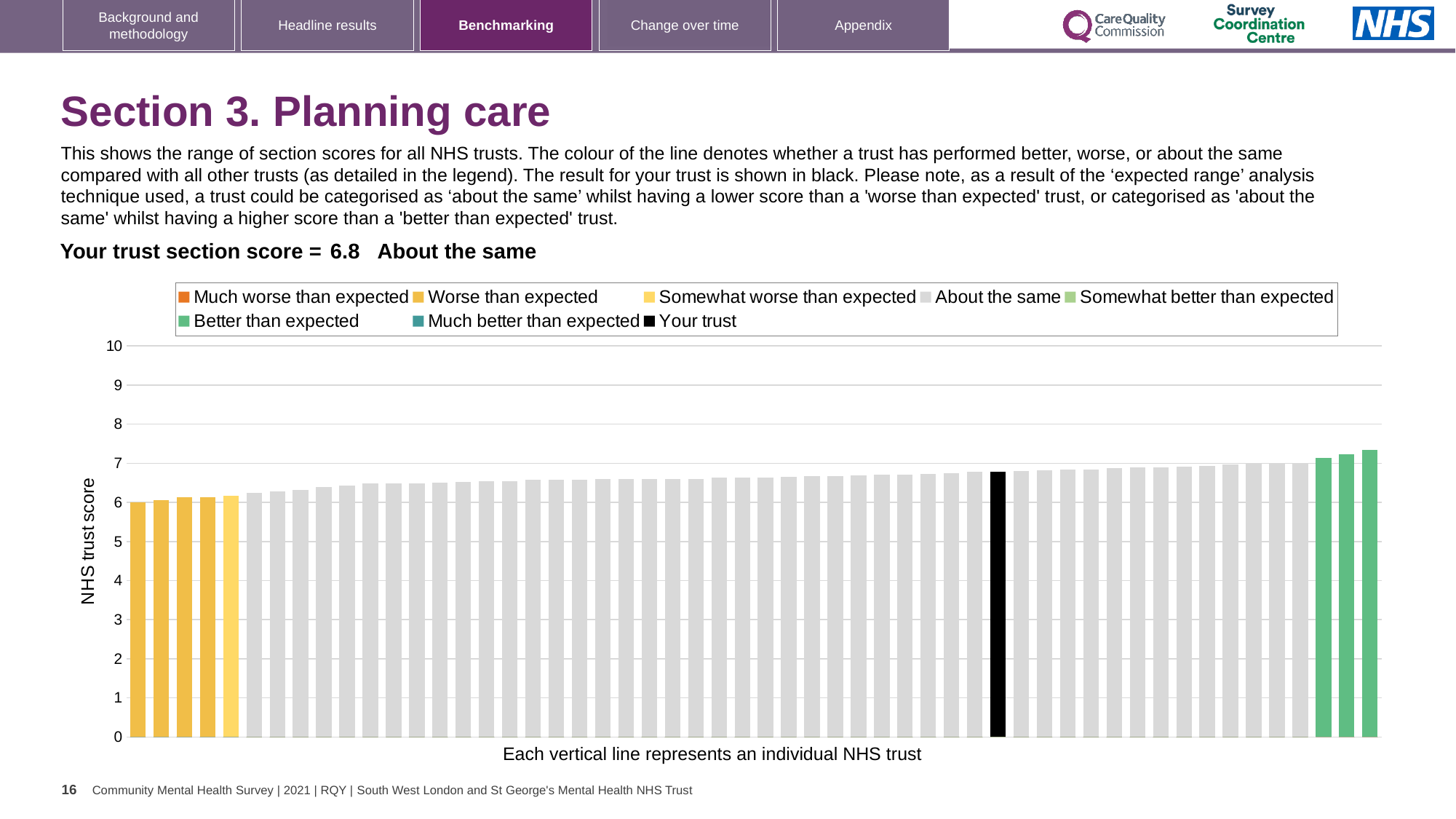
Is the value for the tallest bar greater or less than 8? less What type of chart is shown on the slide? bar chart How is your trust's section score categorised compared with other trusts? About the same How many entries does the chart legend list? 8 Is the value for the black 'Your trust' bar greater or less than 7? less Is the value for the tallest bar (rightmost) greater or less than 7? greater Do the bar values rise or fall from left to right along the x axis? rise What is the label on the vertical axis of the chart? NHS trust score Which bar is the highest: the black 'Your trust' bar or the rightmost green bar? the rightmost green bar What is the section score for your trust shown on the slide? 6.8 What colour is used for the bar representing your trust? black